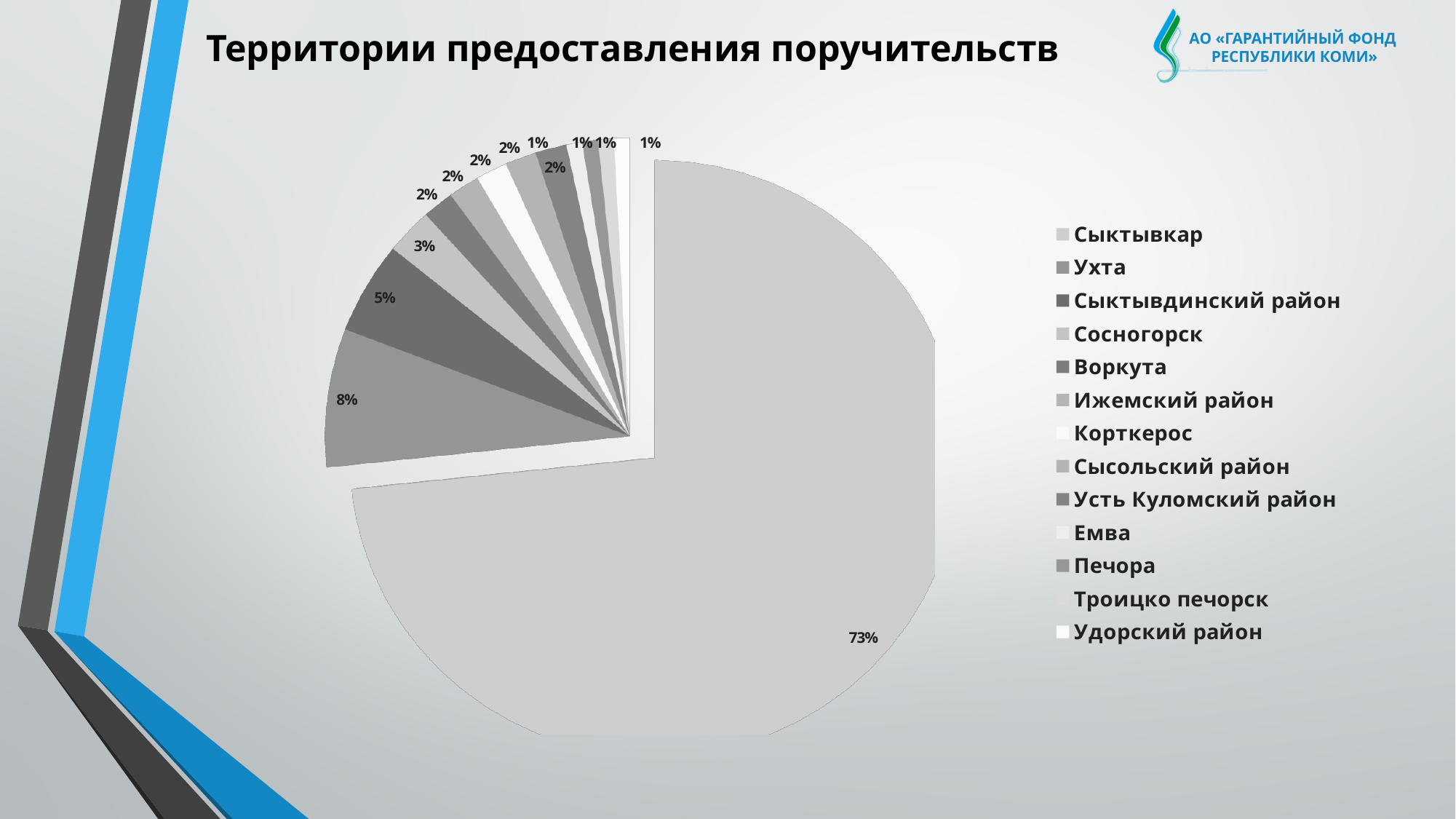
What is the difference in percentage points between Ухта and Сыктывдинский район? 3 What is the title of the slide? Территории предоставления поручительств How many territories are listed in the legend? 13 What is the value shown for Ухта? 8% What is the difference in percentage points between Сыктывкар and Ухта? 65 What is the value shown for Сосногорск? 3% What share of the pie does Сыктывкар hold? 73% What kind of chart is shown on the slide? Pie chart Which is larger, the slice for Ухта or the slice for Сосногорск? Ухта Which territory is listed second in the legend? Ухта What is the value shown for Сыктывдинский район? 5% Which territory has the largest slice of the pie? Сыктывкар